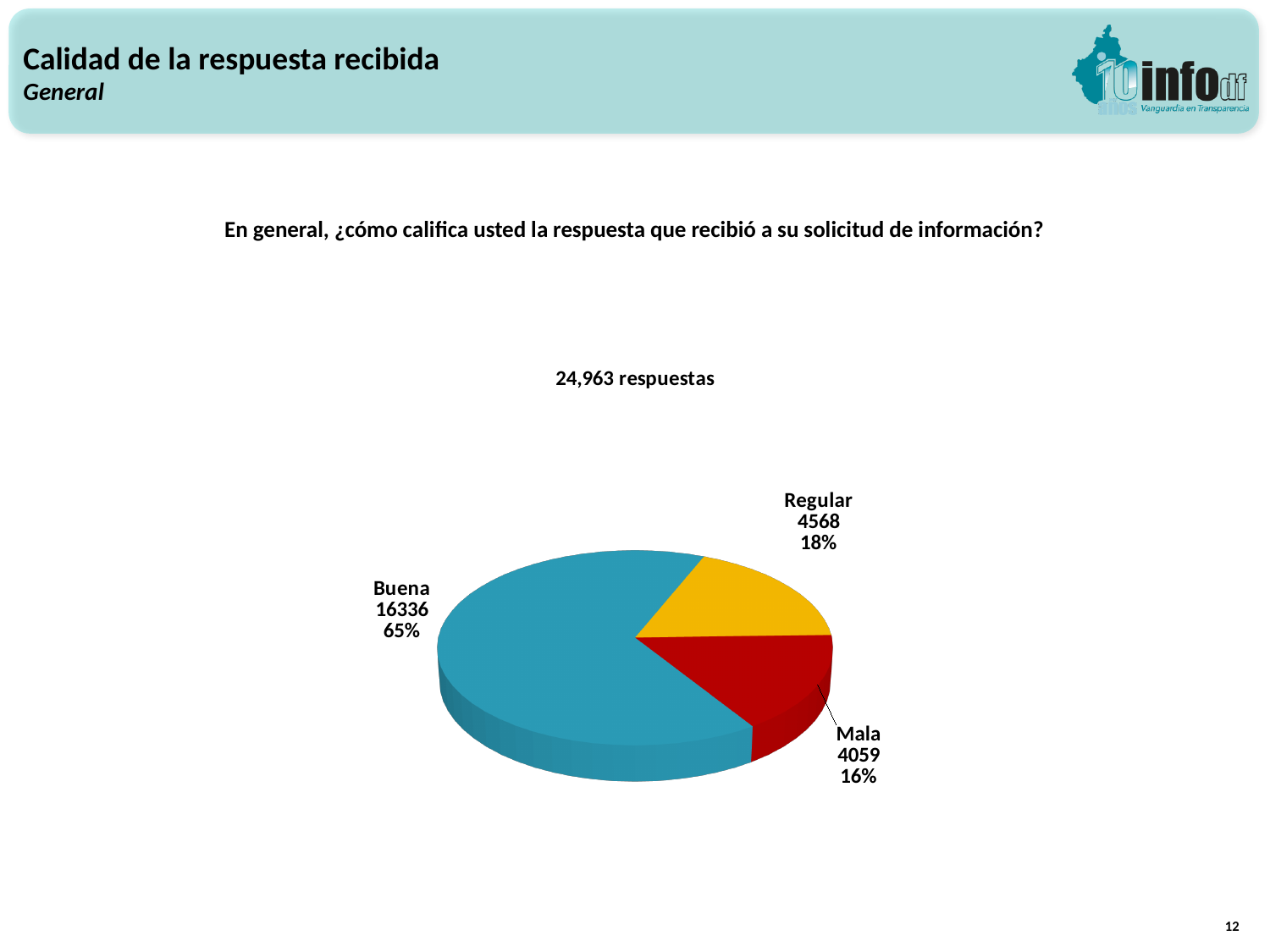
What share of the pie does Buena represent? 65% Which category has the smallest slice? Mala What total number of responses is stated above the chart? 24,963 respuestas Which category has the largest slice? Buena What is the number of responses for Regular? 4568 What is the difference in responses between Regular and Mala? 509 What is the number of responses for Buena? 16336 What is the number of responses for Mala? 4059 How many slices does the pie chart have? 3 Which has more responses, Buena or Regular? Buena What kind of chart is shown on the slide? pie chart What share of the pie does Mala represent? 16%